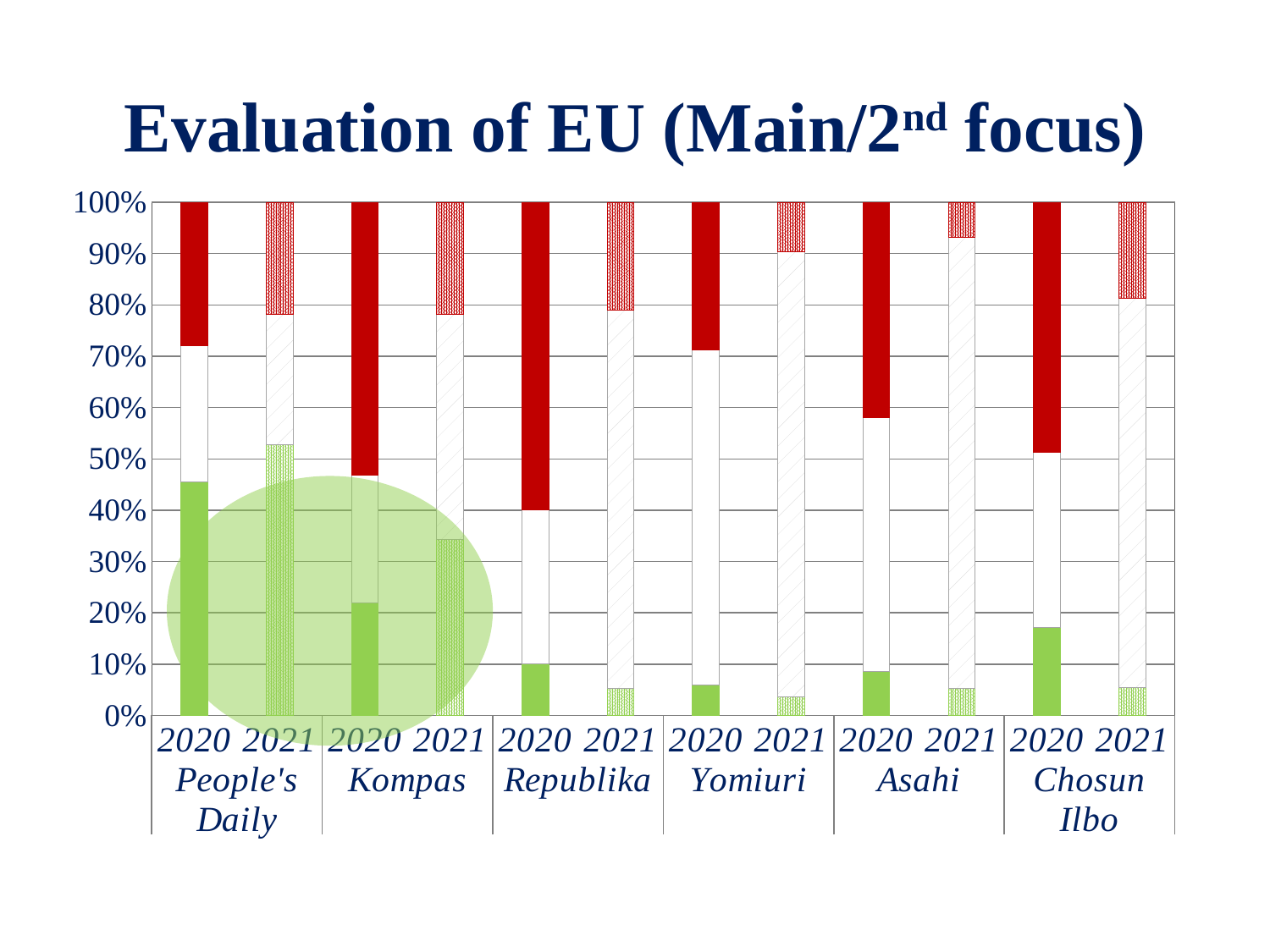
Which bar has the largest green segment? People's Daily 2021 How many bars are plotted in total on the chart? 12 What is the title of the chart? Evaluation of EU (Main/2nd focus) Is the green segment for People's Daily 2020 greater or less than 40%? greater Is the green segment for Chosun Ilbo 2020 greater or less than 10%? greater Is the green segment for Yomiuri 2021 greater or less than 10%? less How many newspapers are shown along the x axis? 6 What kind of chart is shown on the slide? Stacked bar chart Which bar has the largest red segment? Republika 2020 Which has the larger red segment, Yomiuri 2020 or Asahi 2020? Asahi 2020 Which two years are compared for each newspaper? 2020 and 2021